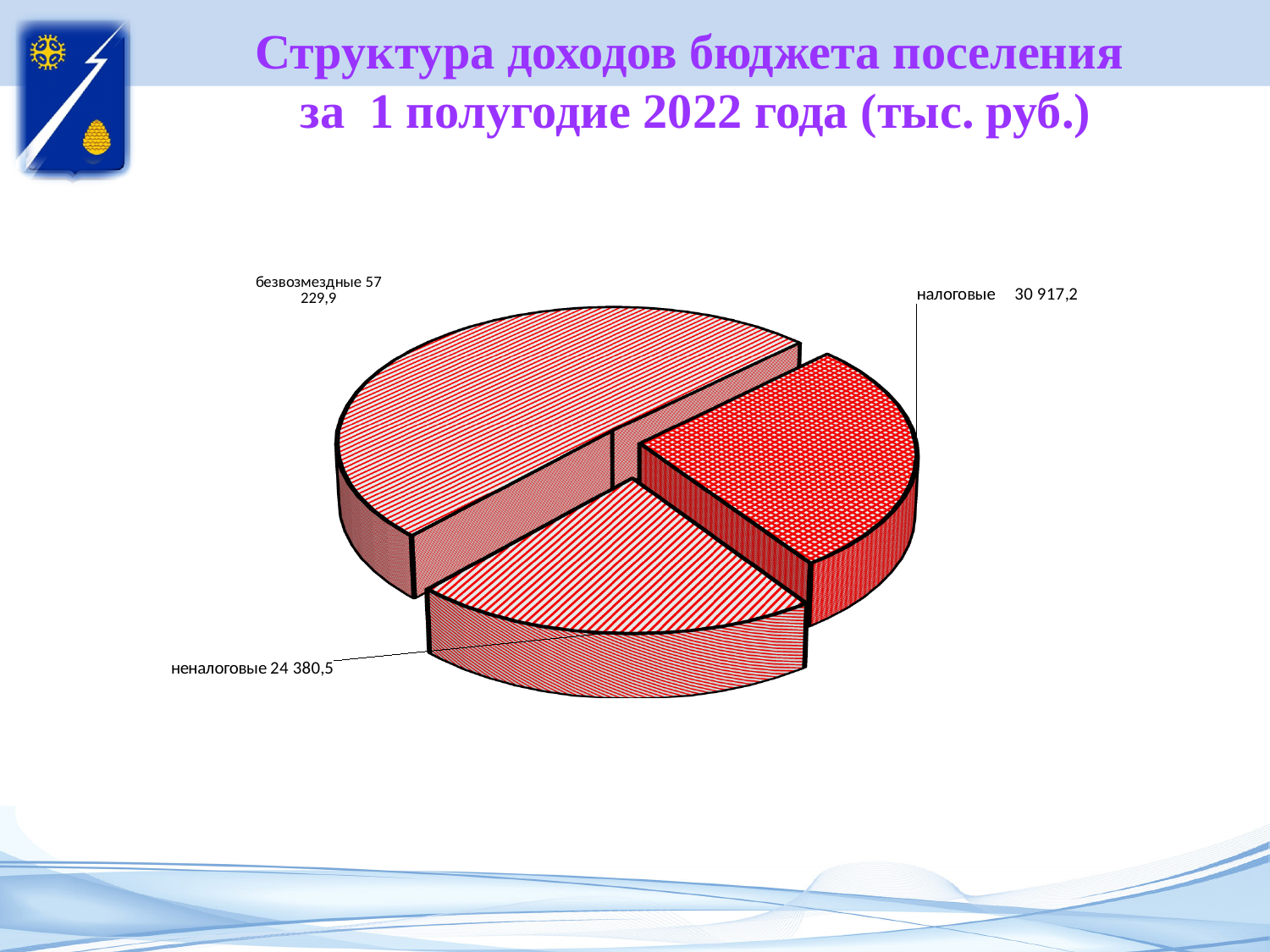
What is the difference between the налоговые and неналоговые values? 6 536,7 What is the total of all three slices in the pie chart? 112 527,6 Which is larger, налоговые or неналоговые? налоговые What is the value for the налоговые slice? 30 917,2 What unit of measurement is stated in the chart title? тыс. руб. What is the value for the неналоговые slice? 24 380,5 Which category has the smallest value in the pie chart? неналоговые Which category has the largest value in the pie chart? безвозмездные How many slices does the pie chart have? 3 What is the difference between the безвозмездные and налоговые values? 26 312,7 What is the value for the безвозмездные slice? 57 229,9 What kind of chart is shown on the slide? Pie chart